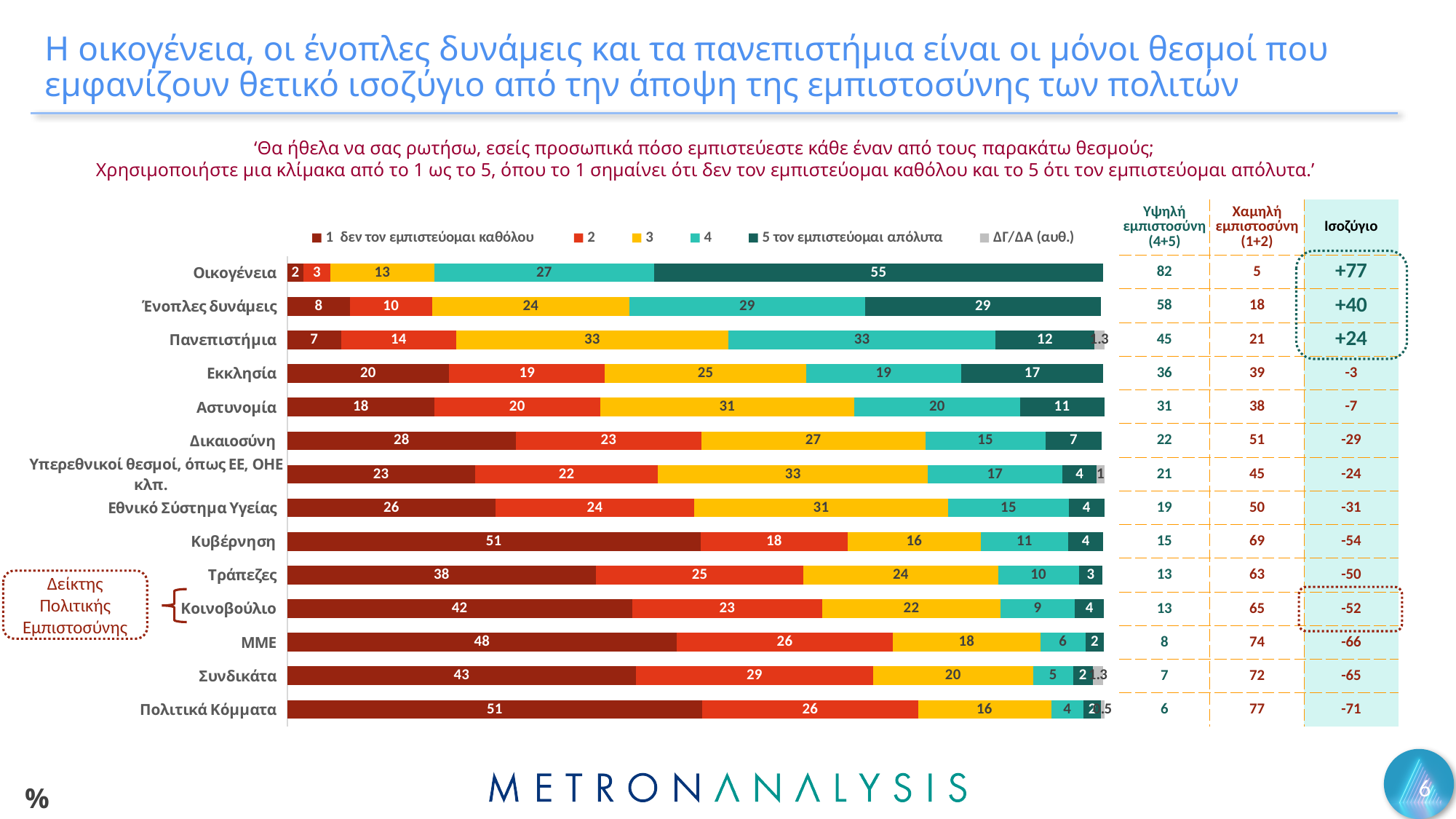
What colour represents the "3" series in the legend? Yellow What is the value of the "4" segment for Πανεπιστήμια? 33 What is the total of the labelled segments in the Οικογένεια bar? 100 How many categories (institutions) are shown in the chart? 14 How many series does the chart legend list? 6 What is the difference between the "3" segment values for Ένοπλες δυνάμεις and Οικογένεια? 11 Which category has the highest value for the "5 τον εμπιστεύομαι απόλυτα" segment? Οικογένεια What is the value of the "1 δεν τον εμπιστεύομαι καθόλου" segment for Κυβέρνηση? 51 What kind of chart is shown on the slide? Stacked bar chart Which category has the lowest value for the "1 δεν τον εμπιστεύομαι καθόλου" segment? Οικογένεια Which has the larger "1 δεν τον εμπιστεύομαι καθόλου" value, ΜΜΕ or Κοινοβούλιο? ΜΜΕ What is the value of the "5 τον εμπιστεύομαι απόλυτα" segment for Οικογένεια? 55